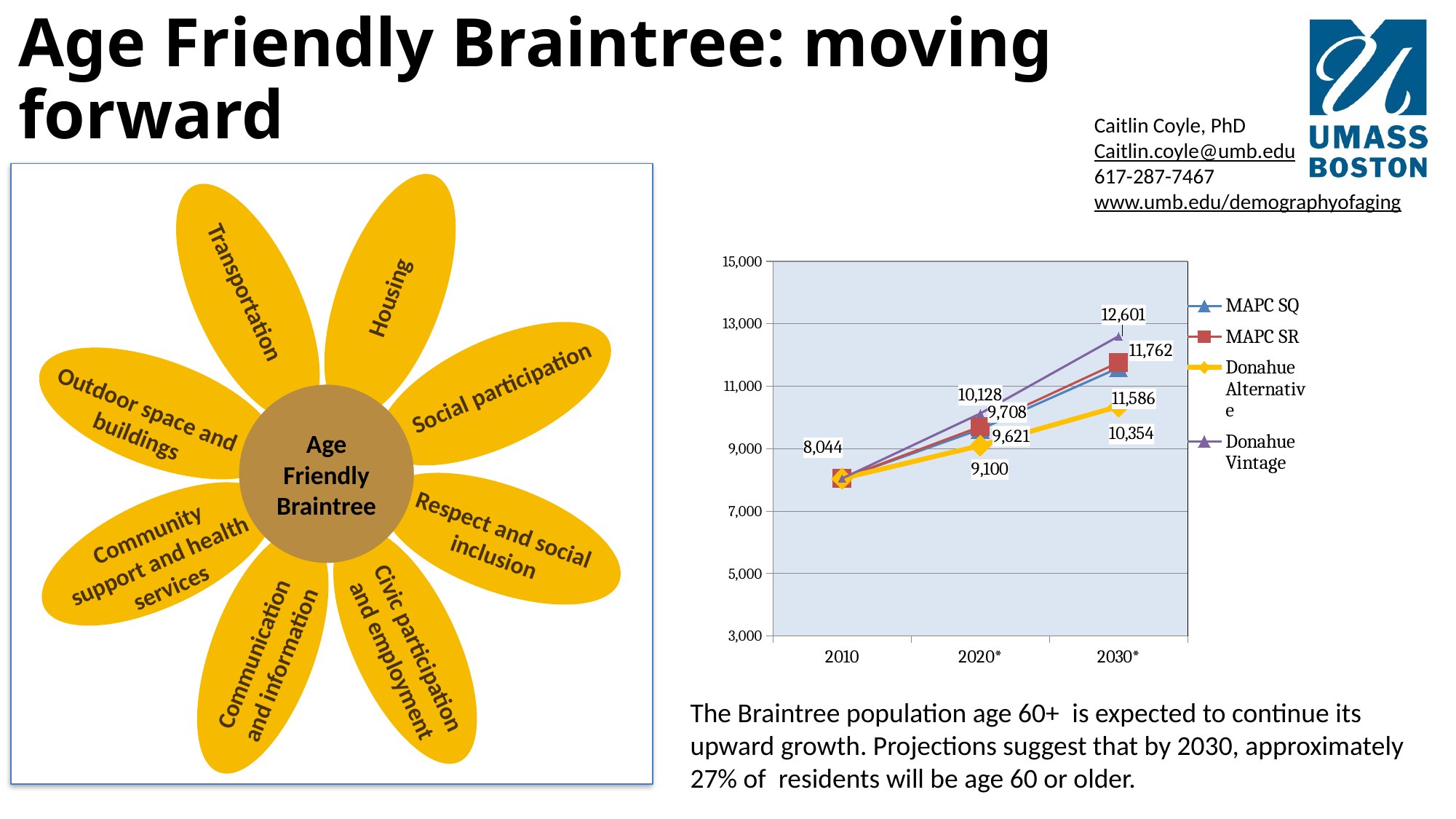
How many years are shown on the x axis of the line chart? 3 Which series has the highest value in 2030* on the line chart? Donahue Vintage Do the values on the line chart rise or fall from 2010 to 2030*? rise Which series has the lowest value in 2030* on the line chart? Donahue Alternative By how much does the Donahue Vintage value increase from 2010 to 2030* on the line chart? 4,557 What is the Donahue Alternative value for 2020* on the line chart? 9,100 What is the Donahue Vintage value for 2030* on the line chart? 12,601 Is the Donahue Vintage value for 2020* greater or less than 10,000? greater What is the value shown for 2010 on the line chart? 8,044 What is the Donahue Alternative value for 2030* on the line chart? 10,354 What kind of chart is shown on the right side of the slide? line chart How many series does the legend of the line chart list? 4